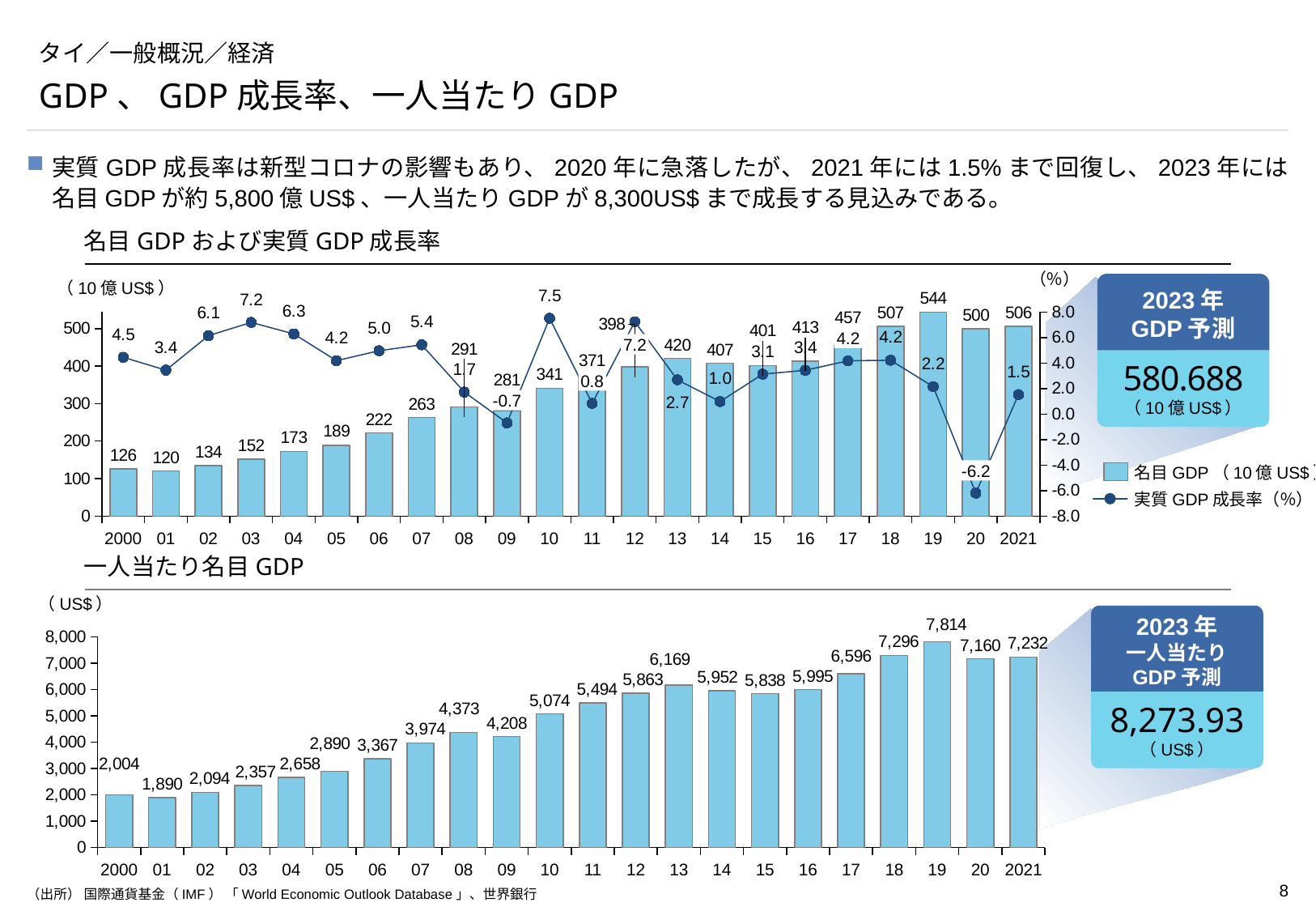
In the top chart (名目GDPおよび実質GDP成長率), what is the difference in nominal GDP between 2021 and 2000? 380 What kind of chart is the bottom chart (一人当たり名目GDP)? Bar chart In the top chart (名目GDPおよび実質GDP成長率), is the nominal GDP for 2012 greater or less than 400? less In the top chart (名目GDPおよび実質GDP成長率), what is the real GDP growth rate for 2020? -6.2 In the bottom chart (一人当たり名目GDP), what is the value for 2019? 7,814 In the top chart (名目GDPおよび実質GDP成長率), what is the nominal GDP value for 2019? 544 In the top chart (名目GDPおよび実質GDP成長率), how many series does the legend list? 2 In the bottom chart (一人当たり名目GDP), which year has the lowest value? 01 In the bottom chart (一人当たり名目GDP), which is larger, the value for 2013 or the value for 2016? 2013 In the top chart (名目GDPおよび実質GDP成長率), which year has the highest real GDP growth rate? 10 In the bottom chart (一人当たり名目GDP), how many years are plotted? 22 In the top chart (名目GDPおよび実質GDP成長率), which year has the lowest nominal GDP? 01